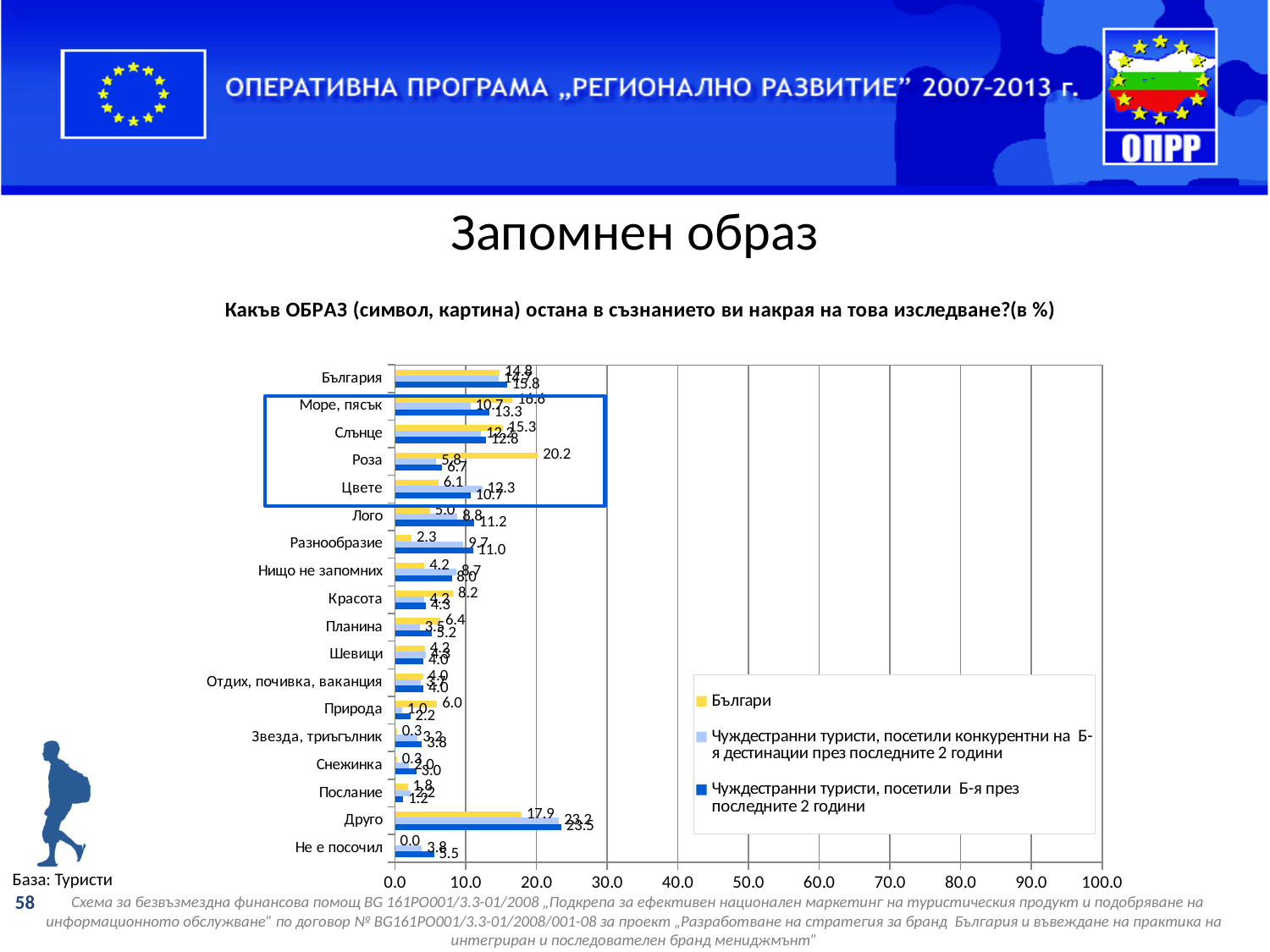
What is the value for Българи in the category Красота? 8.2 Which category has the highest value for the Българи series? Роза What is the difference between the Българи values for Роза (20.2) and Друго (17.9)? 2.3 Which is larger for the category Роза: the value for Българи or the value for Чуждестранни туристи, посетили Б-я през последните 2 години? Българи What is the title of the chart? Какъв ОБРАЗ (символ, картина) остана в съзнанието ви накрая на това изследване?(в %) What is the value for Чуждестранни туристи, посетили Б-я през последните 2 години in the category Море, пясък? 13.3 How many series does the legend list? 3 Is the value for Чуждестранни туристи, посетили Б-я през последните 2 години in the category Друго greater or less than 20.0? greater What is the value for Българи in the category Друго? 17.9 What is the value for Българи in the category Роза? 20.2 What type of chart is shown on the slide? bar chart How many categories are shown on the vertical axis of the chart? 18